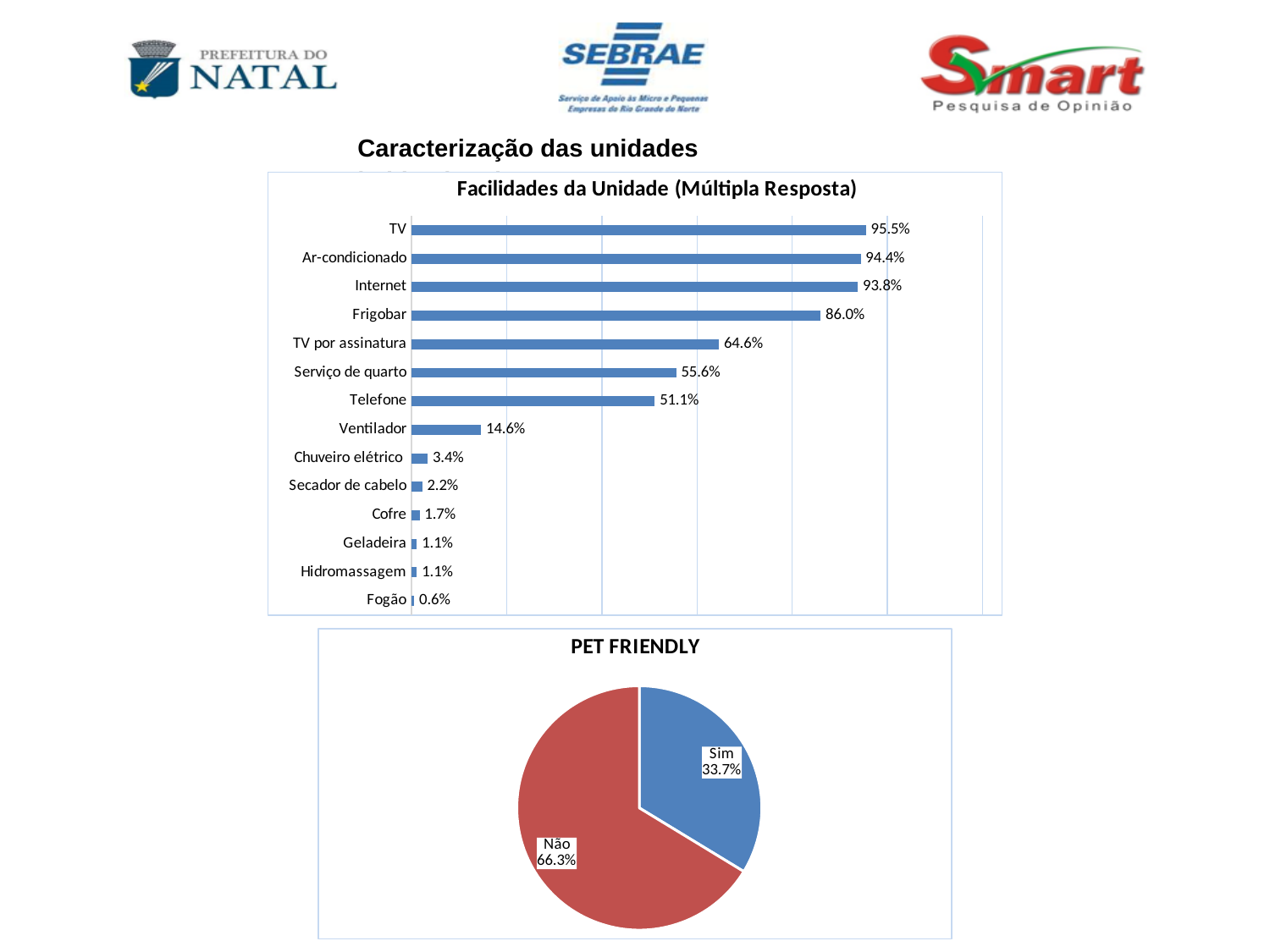
What kind of chart is 'PET FRIENDLY'? Pie chart In the 'PET FRIENDLY' chart, what colour is the 'Não' slice? Red How many categories are shown in the 'Facilidades da Unidade (Múltipla Resposta)' chart? 14 In the 'Facilidades da Unidade (Múltipla Resposta)' chart, which category has the lowest value? Fogão In the 'Facilidades da Unidade (Múltipla Resposta)' chart, what is the value for Frigobar? 86.0% In the 'Facilidades da Unidade (Múltipla Resposta)' chart, which category has the highest value? TV In the 'PET FRIENDLY' chart, what share of the pie is 'Sim'? 33.7% In the 'Facilidades da Unidade (Múltipla Resposta)' chart, what is the difference between TV por assinatura and Telefone? 13.5% In the 'PET FRIENDLY' chart, which slice is larger: Sim or Não? Não In the 'Facilidades da Unidade (Múltipla Resposta)' chart, which is larger: Serviço de quarto or Telefone? Serviço de quarto In the 'Facilidades da Unidade (Múltipla Resposta)' chart, what is the value for Ventilador? 14.6% What kind of chart is 'Facilidades da Unidade (Múltipla Resposta)'? Bar chart